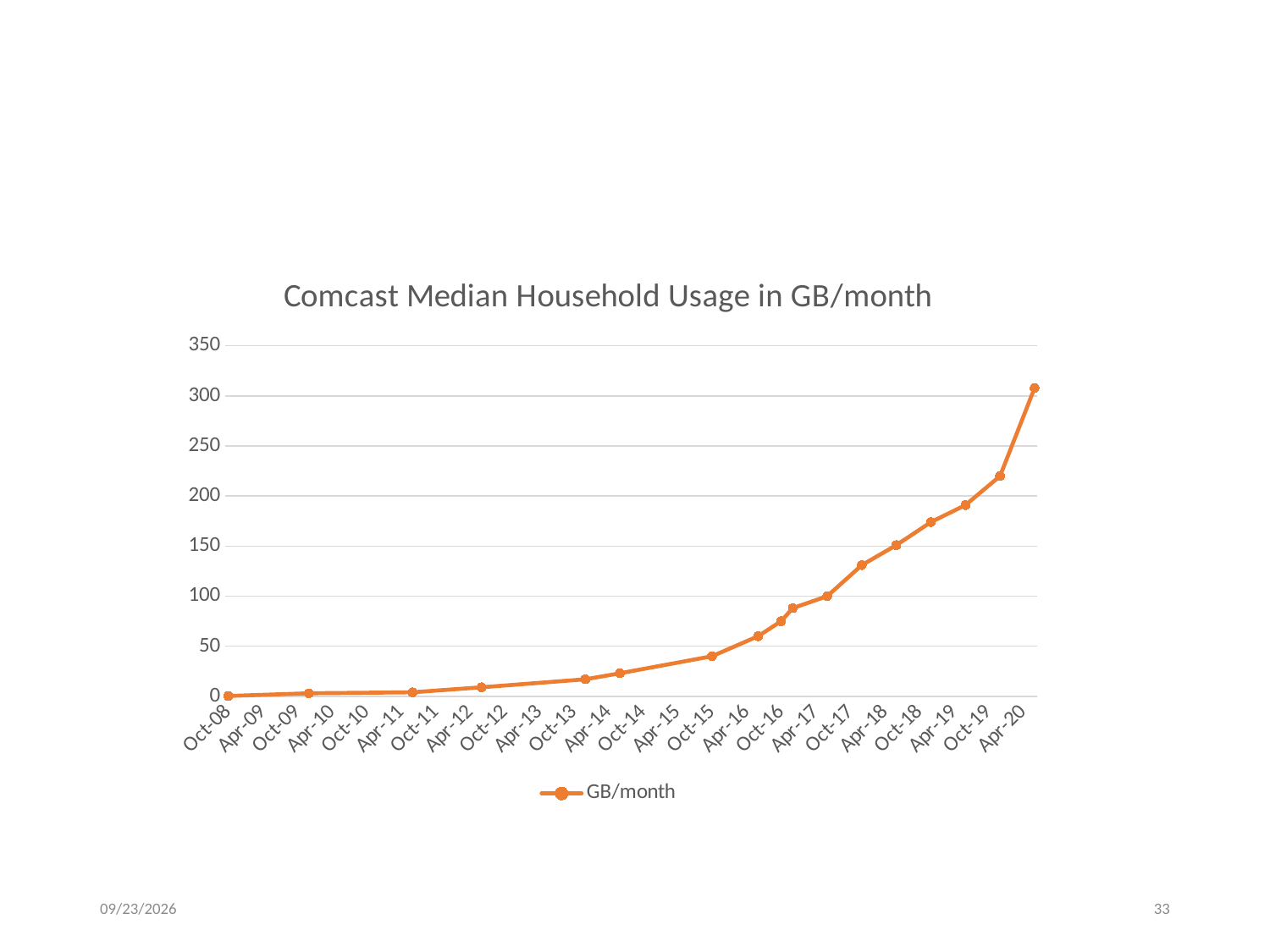
What is the name of the series shown in the legend? GB/month Is the value for Oct-15 greater or less than 50? less Which is larger, the value for Oct-19 or the value for Apr-17? Oct-19 Do the values rise or fall along the x axis from Oct-08 to Apr-20? rise What is the title of the chart? Comcast Median Household Usage in GB/month How many series does the legend list? 1 Is the value for Oct-19 greater or less than 200? greater What kind of chart is shown on the slide? line chart Which x-axis date has the highest value? Apr-20 Is the value for Apr-20 greater or less than 250? greater Which x-axis date has the lowest value? Oct-08